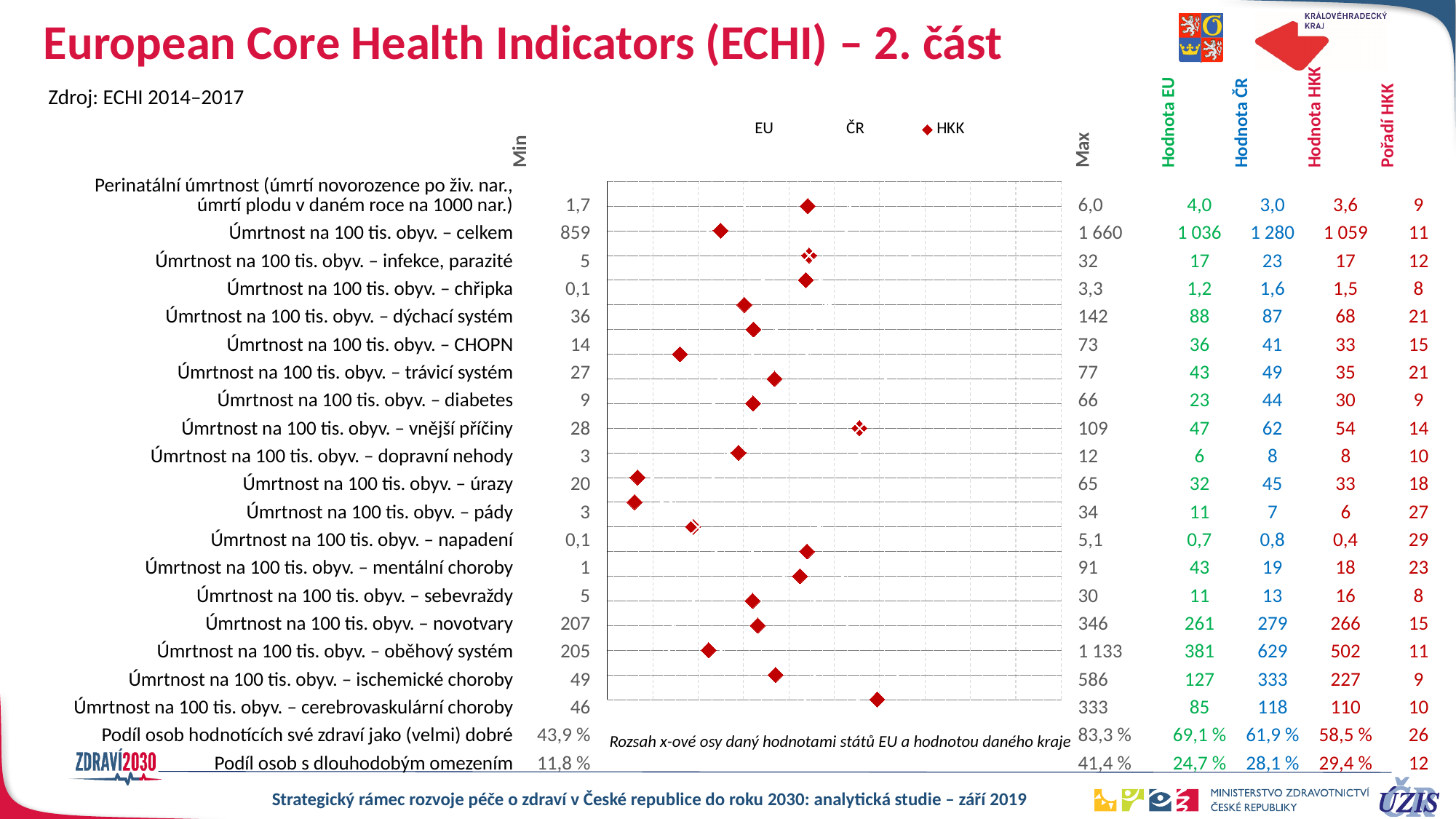
What is the EU value (Hodnota EU) for Úmrtnost na 100 tis. obyv. – novotvary? 261 Which series are listed in the chart legend? EU, ČR, HKK Which indicator has the highest HKK value (Hodnota HKK)? Úmrtnost na 100 tis. obyv. – celkem (1 059) What is the ČR value (Hodnota ČR) for Úmrtnost na 100 tis. obyv. – ischemické choroby? 333 What is the Pořadí HKK (HKK rank) for Podíl osob hodnotících své zdraví jako (velmi) dobré? 26 What is the HKK value (Hodnota HKK) for Úmrtnost na 100 tis. obyv. – CHOPN? 33 How many indicator rows are plotted in the chart? 21 What is the Max value shown for Úmrtnost na 100 tis. obyv. – oběhový systém? 1 133 Which is larger for Úmrtnost na 100 tis. obyv. – celkem: the EU value or the ČR value? ČR value (1 280) How many series does the chart legend list? 3 What is the difference between the ČR value and the EU value for Úmrtnost na 100 tis. obyv. – celkem? 244 What kind of chart is shown on the slide? dot (scatter) chart